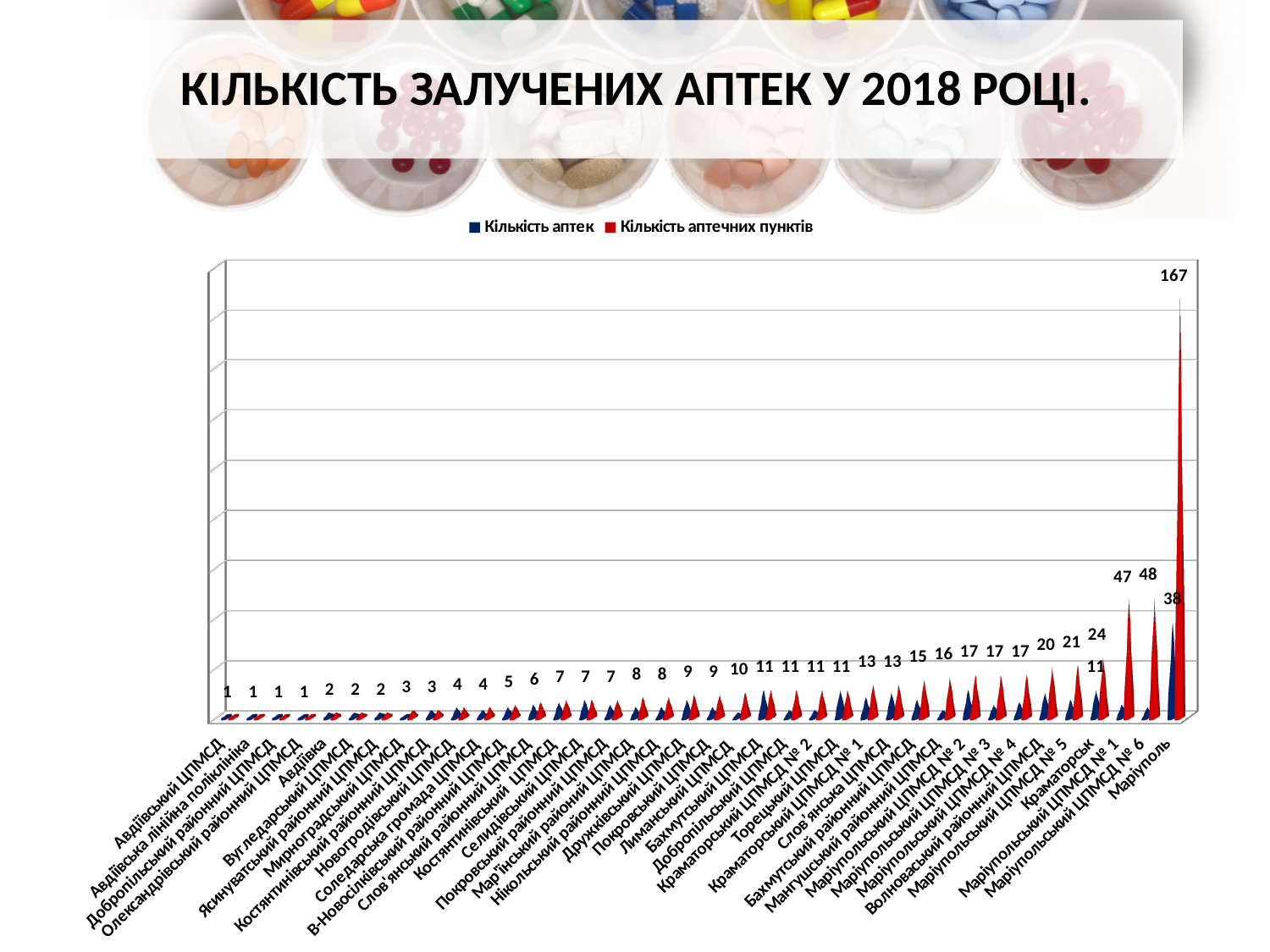
Which series is shown in red in the chart? Кількість аптечних пунктів What kind of chart is shown on the slide? bar chart Which category has the highest value in the chart? Маріуполь What is the value of Кількість аптечних пунктів for Маріуполь? 167 Do the values generally rise or fall from left to right along the x axis? rise What is the value of Кількість аптек for Маріуполь? 38 What is the title of the chart on the slide? КІЛЬКІСТЬ ЗАЛУЧЕНИХ АПТЕК У 2018 РОЦІ. How many series does the chart legend list? 2 For Маріуполь, what is the difference between Кількість аптечних пунктів and Кількість аптек? 129 What is the highest value labelled in the chart? 167 How many categories are shown on the x axis of the chart? 38 Which has the larger value of Кількість аптечних пунктів: Маріуполь or Маріупольський ЦПМСД № 6? Маріуполь